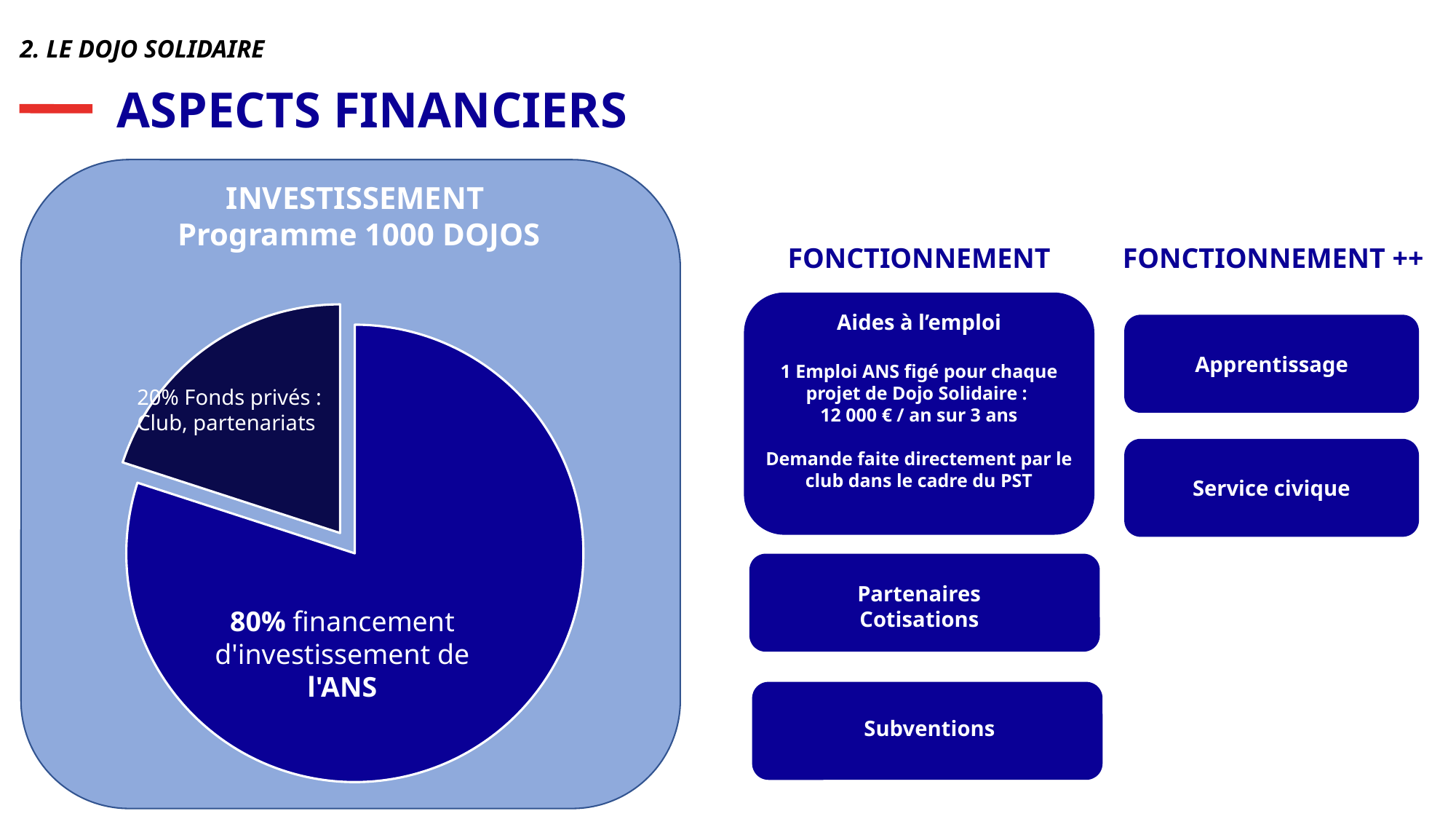
Which is larger in the pie chart: the ANS slice or the Fonds privés slice? the ANS slice Is the share of the ANS slice greater or less than 50%? greater What colour is the 'Fonds privés' slice of the pie chart? dark navy blue What share of the pie chart is labelled 'financement d'investissement de l'ANS'? 80% What is the title shown above the pie chart? INVESTISSEMENT Programme 1000 DOJOS Which slice of the pie chart is the smallest? Fonds privés : Club, partenariats Which slice of the pie chart is the largest? financement d'investissement de l'ANS What share of the pie chart is labelled 'Fonds privés : Club, partenariats'? 20% How many slices does the pie chart have? 2 What kind of chart is shown under the heading 'INVESTISSEMENT Programme 1000 DOJOS'? pie chart What is the difference in percentage points between the ANS slice and the Fonds privés slice? 60